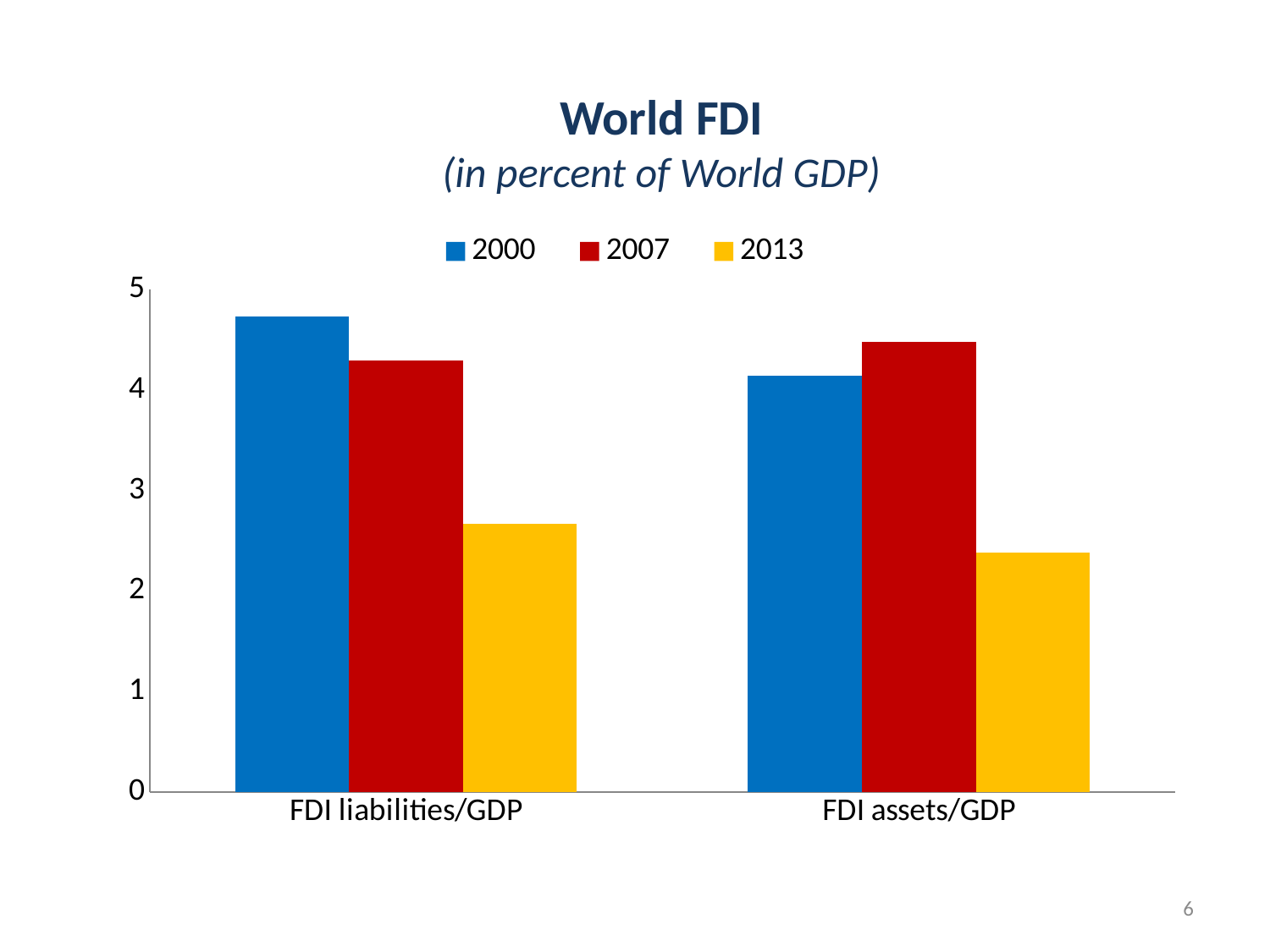
What is the title of the chart? World FDI (in percent of World GDP) What kind of chart is shown on the slide? bar chart Is the 2013 value for FDI liabilities/GDP greater or less than 2? greater Which year has the lowest value for FDI liabilities/GDP? 2013 Which year has the lowest value for FDI assets/GDP? 2013 Is the 2013 value for FDI assets/GDP greater or less than 3? less How many categories are shown on the x axis? 2 How many series does the legend list? 3 Which year has the highest value for FDI liabilities/GDP? 2000 Is the 2000 value for FDI liabilities/GDP greater or less than 4? greater Which year has the highest value for FDI assets/GDP? 2007 For FDI assets/GDP, which is larger: the 2000 value or the 2007 value? 2007